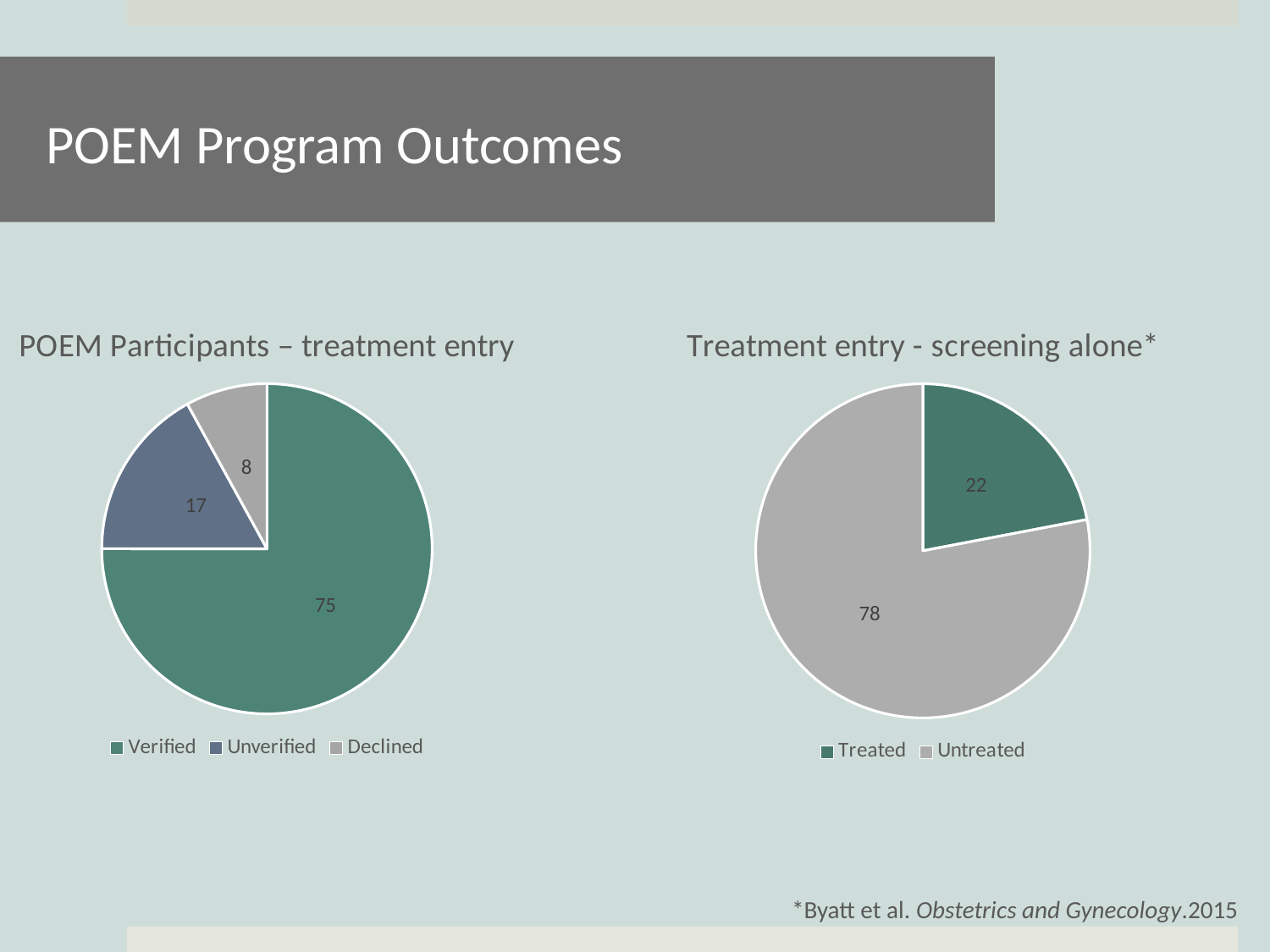
In the 'POEM Participants – treatment entry' chart, how many categories does the legend list? 3 In the 'Treatment entry - screening alone*' chart, what is the value for Treated? 22 In the 'POEM Participants – treatment entry' chart, what is the value for Unverified? 17 In the 'Treatment entry - screening alone*' chart, what is the value for Untreated? 78 In the 'POEM Participants – treatment entry' chart, what is the difference between the Unverified and Declined values? 9 In the 'POEM Participants – treatment entry' chart, what is the value for Verified? 75 In the 'Treatment entry - screening alone*' chart, which is larger, Treated or Untreated? Untreated In the 'POEM Participants – treatment entry' chart, what is the value for Declined? 8 In the 'Treatment entry - screening alone*' chart, what is the difference between the Untreated and Treated values? 56 In the 'POEM Participants – treatment entry' chart, which category has the smallest slice? Declined What type of chart is the 'Treatment entry - screening alone*' chart? Pie chart In the 'POEM Participants – treatment entry' chart, which category has the largest slice? Verified